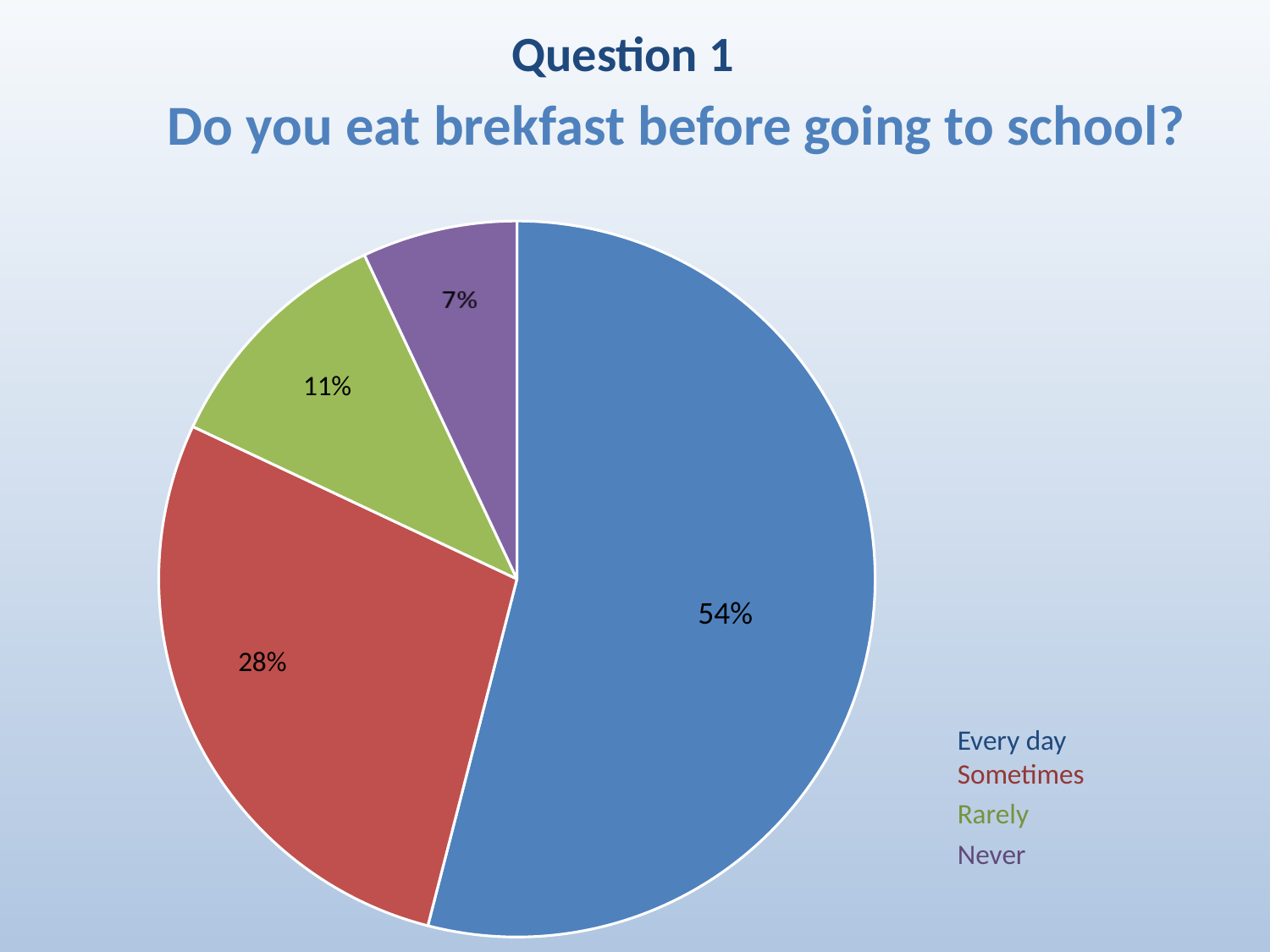
What percentage of respondents answered 'Sometimes'? 28% How many slices does the pie chart have? 4 What percentage of respondents eat breakfast every day? 54% Which response has the smallest share of the pie? Never What percentage of respondents answered 'Never'? 7% What question does the chart title ask? Do you eat brekfast before going to school? Which is larger, the 'Rarely' slice or the 'Never' slice? Rarely What colour is the 'Sometimes' slice? red Which response has the largest share of the pie? Every day What percentage of respondents answered 'Rarely'? 11% How many percentage points larger is the 'Every day' slice than the 'Sometimes' slice? 26 What kind of chart is shown on the slide? pie chart